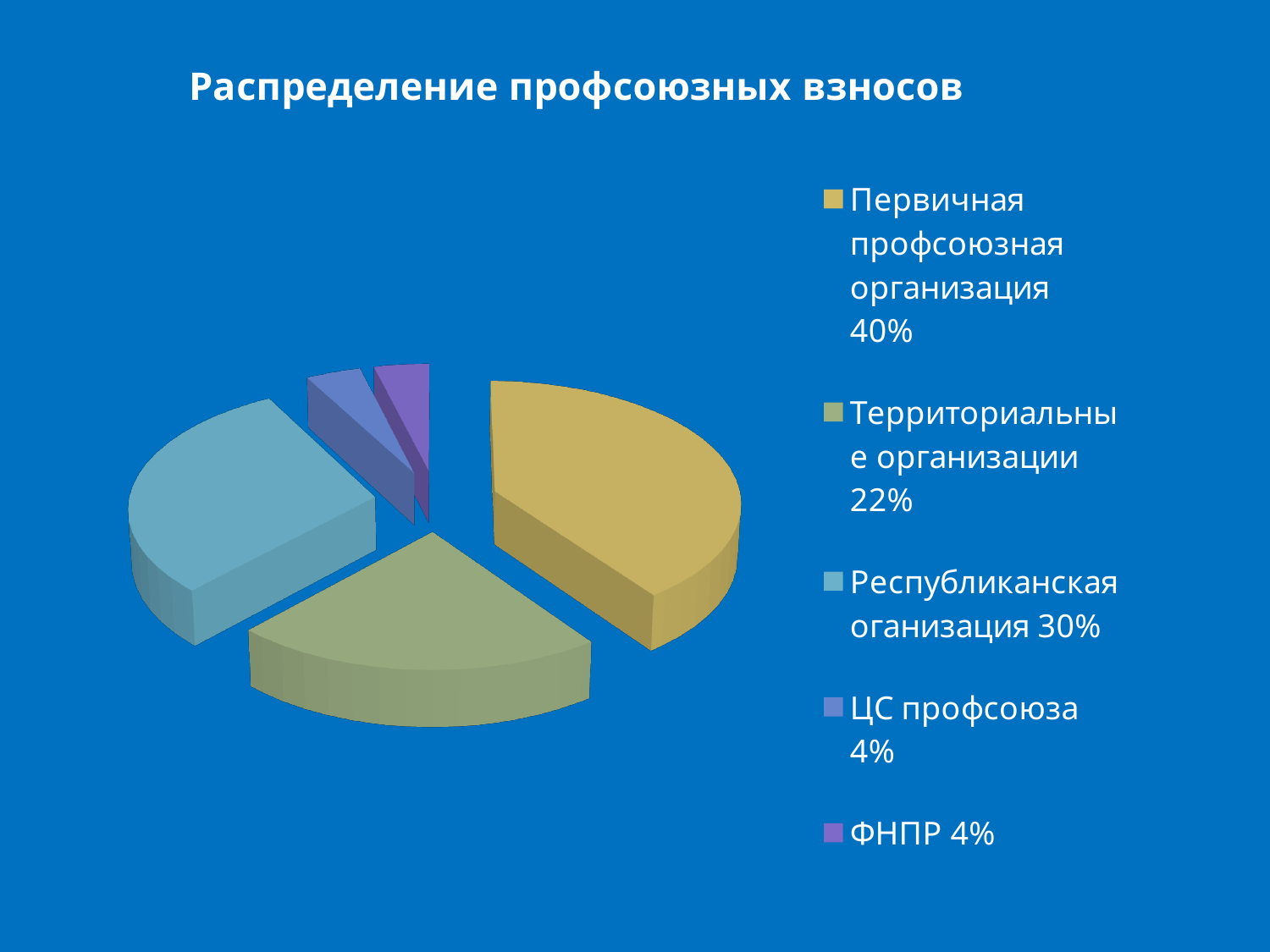
Which is larger: the share for Республиканская оганизация or for Территориальные организации? Республиканская оганизация What is the title of the chart? Распределение профсоюзных взносов What share of the pie is Первичная профсоюзная организация? 40% How many slices does the pie chart have? 5 What kind of chart is shown on the slide? pie chart What is the difference between the share for Республиканская оганизация and the share for ЦС профсоюза? 26% Which category has the largest share of the pie? Первичная профсоюзная организация What share of the pie is ФНПР? 4% What share of the pie is Республиканская оганизация? 30% What is the difference between the share for Первичная профсоюзная организация and the share for Территориальные организации? 18%